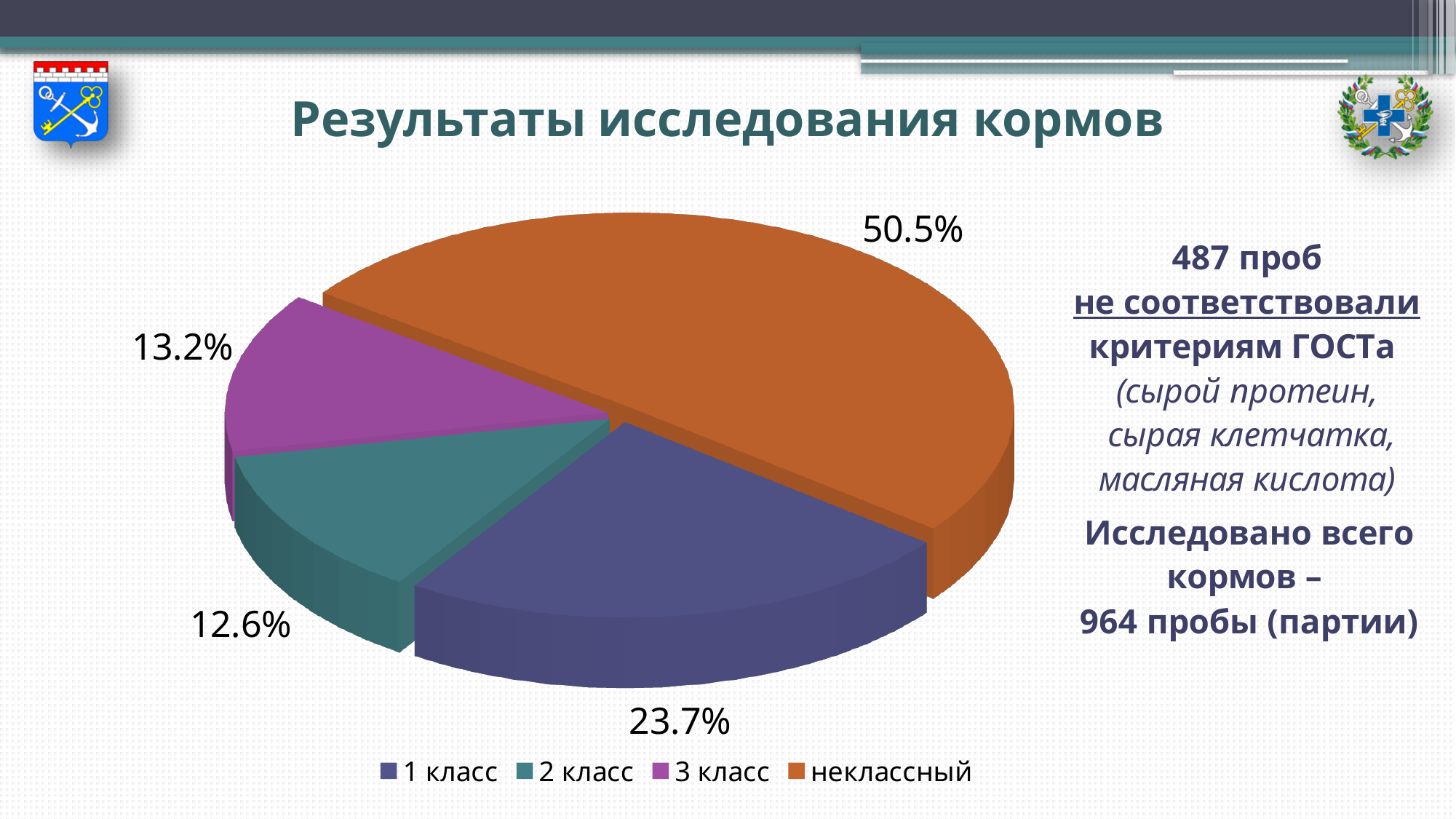
Which category has the largest slice of the pie? неклассный What is the value shown for "2 класс"? 12.6% How many entries does the legend list? 4 What is the difference between the values for "неклассный" and "1 класс"? 26.8% What colour is the "неклассный" slice? orange How many slices does the pie chart have? 4 What is the value shown for "3 класс"? 13.2% What is the value shown for "1 класс"? 23.7% What kind of chart is shown on the slide? pie chart Which is larger, the value for "3 класс" or the value for "2 класс"? 3 класс What share of the pie does the "неклассный" slice represent? 50.5% Which category has the smallest slice of the pie? 2 класс